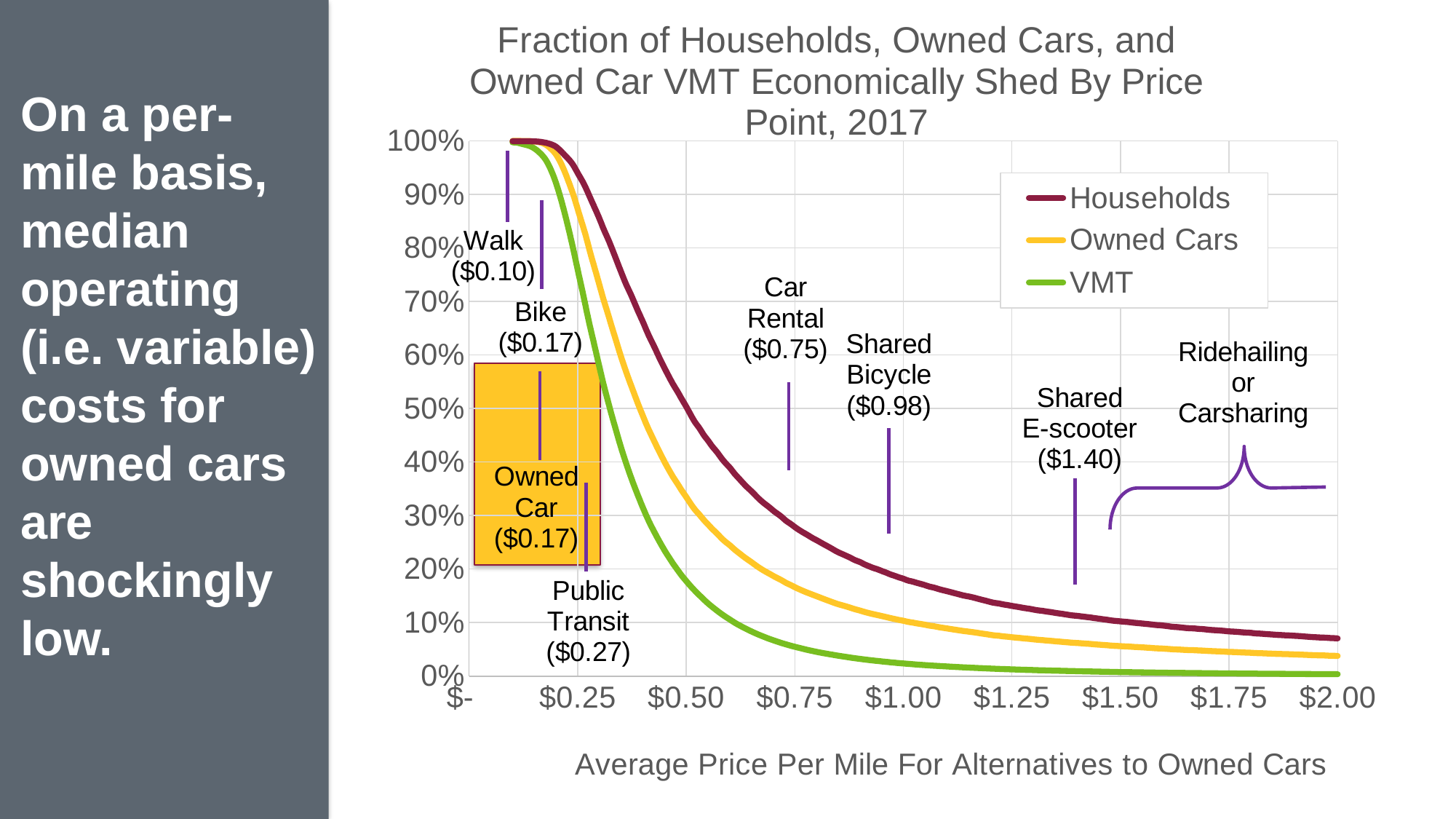
What price per mile is annotated for Shared E-scooter? $1.40 Is the Households value at $2.00 greater or less than 10%? less Which series are listed in the chart legend? Households, Owned Cars, VMT What price per mile is annotated for Public Transit? $0.27 Which series has the lowest value at $2.00? VMT Which series has the highest value at $2.00? Households What kind of chart is shown on the slide? line chart Is the VMT value at $0.50 greater or less than 20%? less What is the x-axis label of the chart? Average Price Per Mile For Alternatives to Owned Cars At $1.00, which is larger, the Households value or the VMT value? Households How many series does the legend list? 3 Do the plotted lines rise or fall as the price per mile increases along the x axis? fall